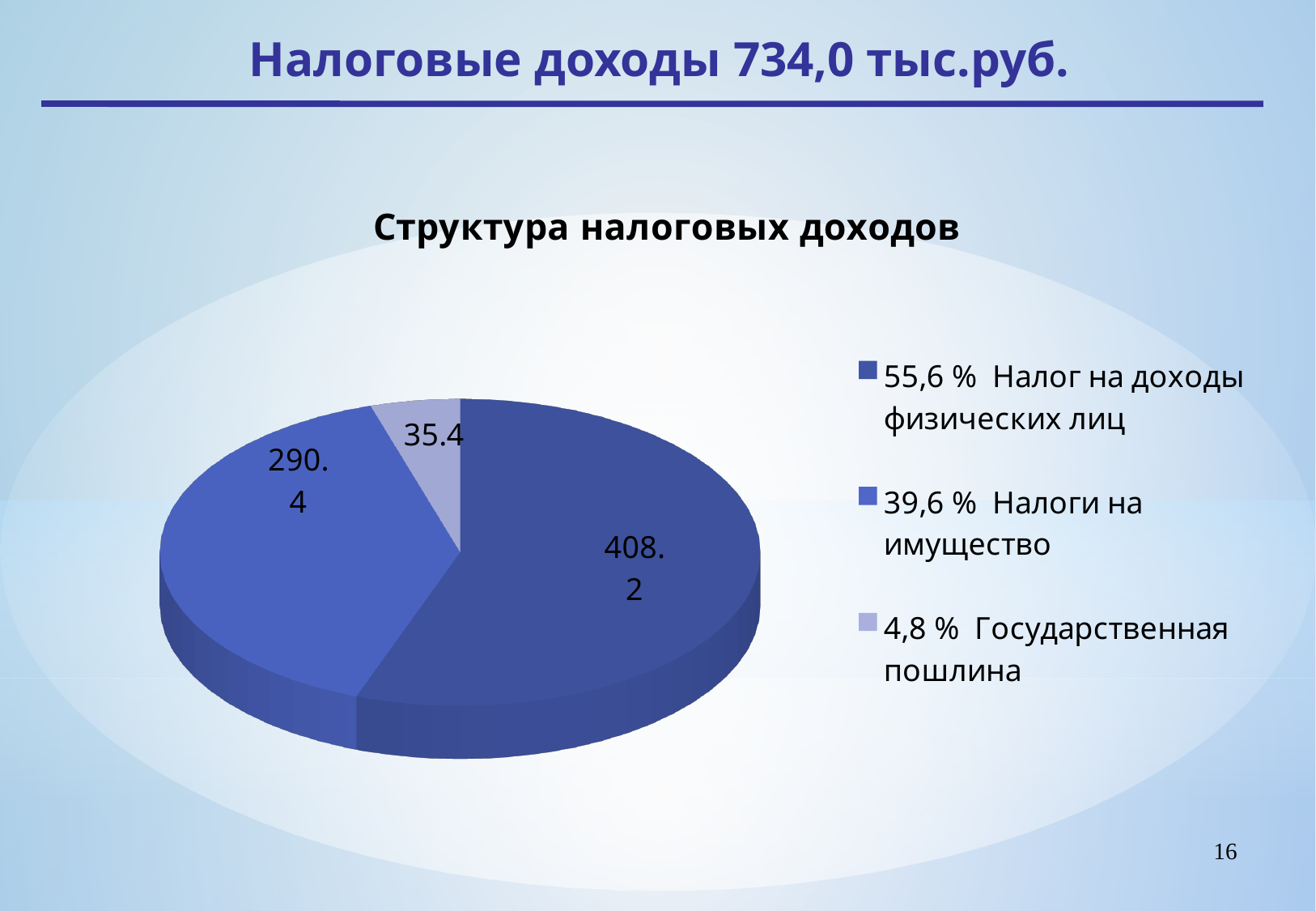
What is the value shown for Государственная пошлина? 35.4 Which category has the largest slice of the pie? Налог на доходы физических лиц What type of chart is shown on the slide? pie chart What is the value shown for Налог на доходы физических лиц? 408.2 What is the title of the chart? Структура налоговых доходов What share of the pie does Государственная пошлина represent, according to the legend? 4,8 % What share of the pie does Налоги на имущество represent, according to the legend? 39,6 % Which category has the smallest slice of the pie? Государственная пошлина What is the difference between the values for Налог на доходы физических лиц and Налоги на имущество? 117.8 Which is larger: the value for Налоги на имущество or the value for Государственная пошлина? Налоги на имущество How many slices does the pie chart have? 3 What is the value shown for Налоги на имущество? 290.4